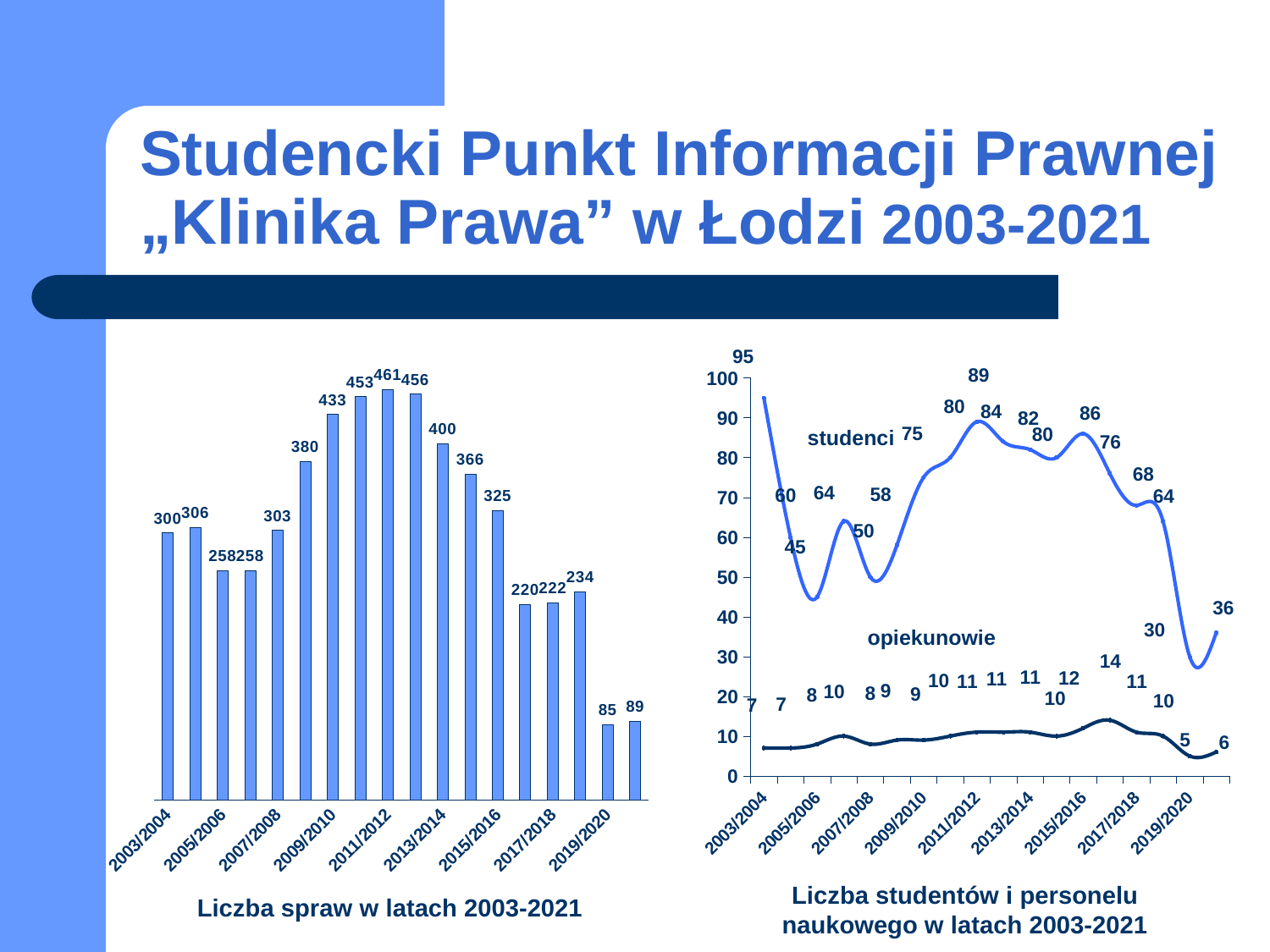
In the right chart, what is the value of the 'studenci' series for 2003/2004? 95 In the left chart 'Liczba spraw w latach 2003-2021', what is the highest value shown? 461 In the right chart, what is the highest value of the 'opiekunowie' series? 14 In the left chart 'Liczba spraw w latach 2003-2021', what is the value for 2009/2010? 433 In the right chart, which is larger for the 'studenci' series: the value for 2007/2008 or the value for 2013/2014? 2013/2014 What kind of chart is the left chart, 'Liczba spraw w latach 2003-2021'? bar chart In the left chart 'Liczba spraw w latach 2003-2021', what is the lowest value shown? 85 In the left chart 'Liczba spraw w latach 2003-2021', what is the difference between the values for 2003/2004 and 2019/2020? 215 In the right chart, what is the lowest value of the 'studenci' series? 30 How many bars are plotted in the left chart 'Liczba spraw w latach 2003-2021'? 18 What kind of chart is the right chart, 'Liczba studentów i personelu naukowego w latach 2003-2021'? line chart How many series are plotted in the right chart 'Liczba studentów i personelu naukowego w latach 2003-2021'? 2